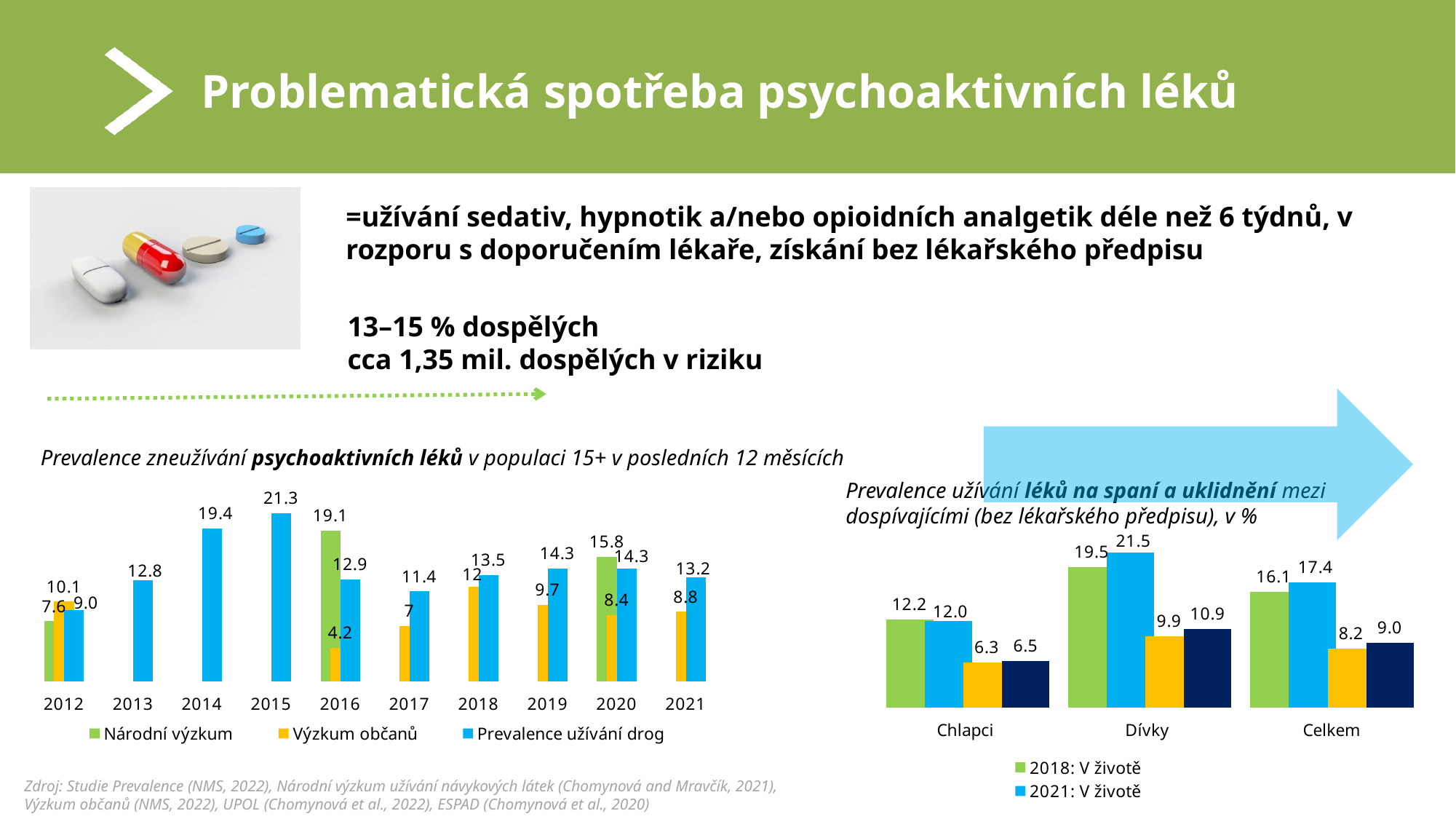
In the left chart (Prevalence zneužívání psychoaktivních léků), which is larger for 2018: Výzkum občanů or Prevalence užívání drog? Prevalence užívání drog In the left chart (Prevalence zneužívání psychoaktivních léků), what is the value of Národní výzkum for 2016? 19.1 In the left chart (Prevalence zneužívání psychoaktivních léků), which year has the highest value for Prevalence užívání drog? 2015 In the left chart (Prevalence zneužívání psychoaktivních léků), what is the difference between the Prevalence užívání drog values for 2015 and 2016? 8.4 In the left chart (Prevalence zneužívání psychoaktivních léků), what is the value of Prevalence užívání drog for 2015? 21.3 In the right chart (Prevalence užívání léků na spaní a uklidnění mezi dospívajícími), what is the value of 2021: V životě for Dívky? 21.5 In the right chart (Prevalence užívání léků na spaní a uklidnění mezi dospívajícími), what is the value of 2018: V životě for Celkem? 16.1 In the left chart (Prevalence zneužívání psychoaktivních léků), how many series does the legend list? 3 In the right chart (Prevalence užívání léků na spaní a uklidnění mezi dospívajícími), what is the difference between the 2021: V životě values for Dívky and Chlapci? 9.5 What type of chart is the right chart (Prevalence užívání léků na spaní a uklidnění mezi dospívajícími)? Bar chart In the left chart (Prevalence zneužívání psychoaktivních léků), how many years are shown on the x axis? 10 In the left chart (Prevalence zneužívání psychoaktivních léků), what is the value of Výzkum občanů for 2021? 8.8